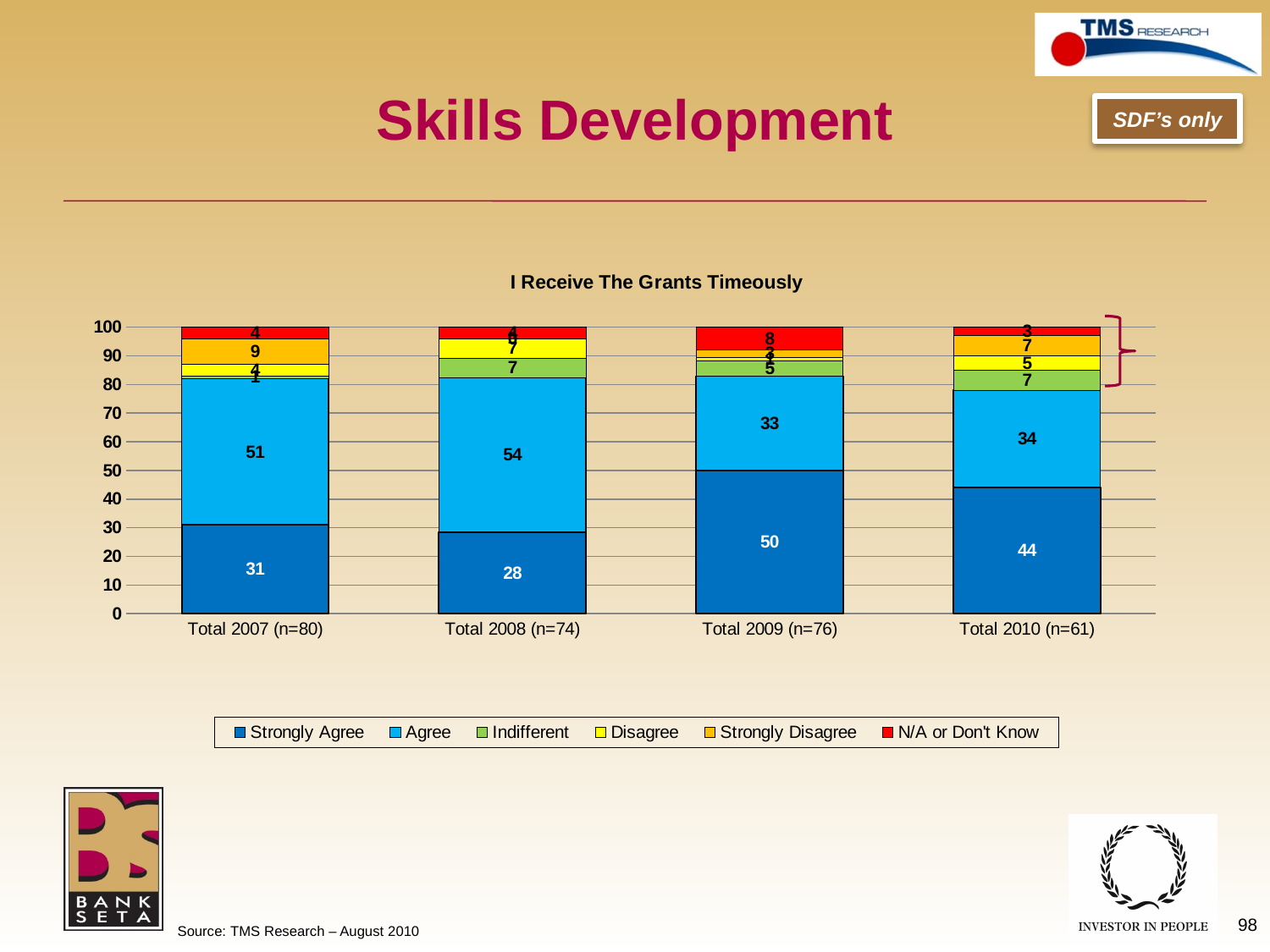
What is the value for Agree in Total 2008 (n=74)? 54 What is the value for Indifferent in Total 2010 (n=61)? 7 Which is larger: Strongly Agree in Total 2010 (n=61) or Agree in Total 2010 (n=61)? Strongly Agree How many categories are shown on the x axis? 4 How many series does the legend list? 6 What is the value for Strongly Agree in Total 2007 (n=80)? 31 What is the difference between the Agree values for Total 2008 (n=74) and Total 2009 (n=76)? 21 What kind of chart is shown on the slide? Stacked bar chart Which category has the lowest value for Strongly Agree? Total 2008 (n=74) Which category has the highest value for Strongly Agree? Total 2009 (n=76) What is the value for Strongly Agree in Total 2009 (n=76)? 50 What is the value for N/A or Don't Know in Total 2009 (n=76)? 8